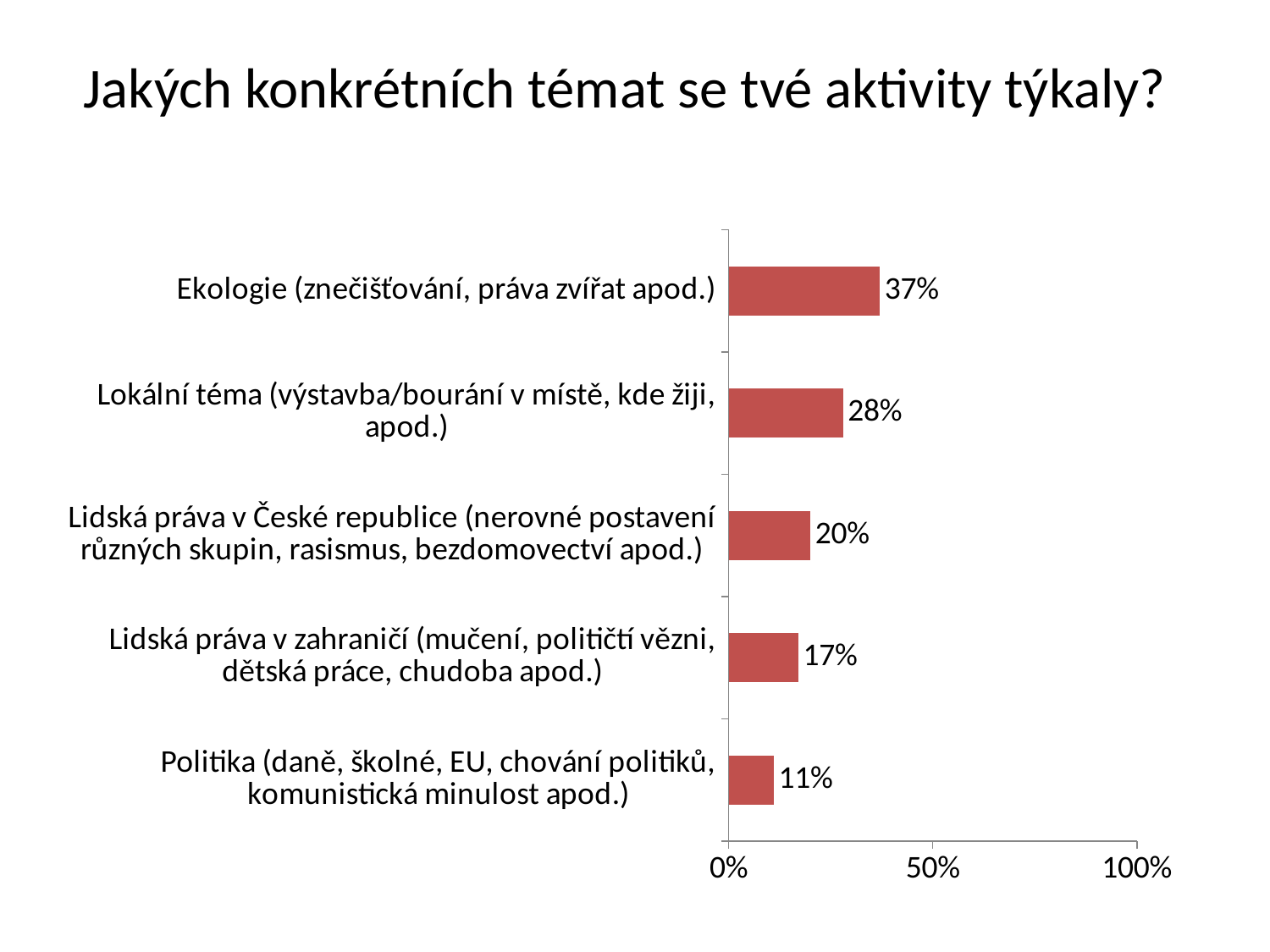
Which category has the lowest value? Politika (daně, školné, EU, chování politiků, komunistická minulost apod.) Which category has the highest value? Ekologie (znečišťování, práva zvířat apod.) What is the value for Lidská práva v zahraničí (mučení, političtí vězni, dětská práce, chudoba apod.)? 17% What kind of chart is shown on the slide? bar chart What is the value for Politika (daně, školné, EU, chování politiků, komunistická minulost apod.)? 11% How many categories are shown in the chart? 5 What is the title of the slide? Jakých konkrétních témat se tvé aktivity týkaly? What is the difference between the values for Ekologie and Lokální téma? 9% Which is larger, the value for Lokální téma or the value for Lidská práva v zahraničí? Lokální téma What is the difference between the values for Lidská práva v České republice and Politika? 9% What is the value for Ekologie (znečišťování, práva zvířat apod.)? 37% Is the value for Ekologie greater or less than 50%? less